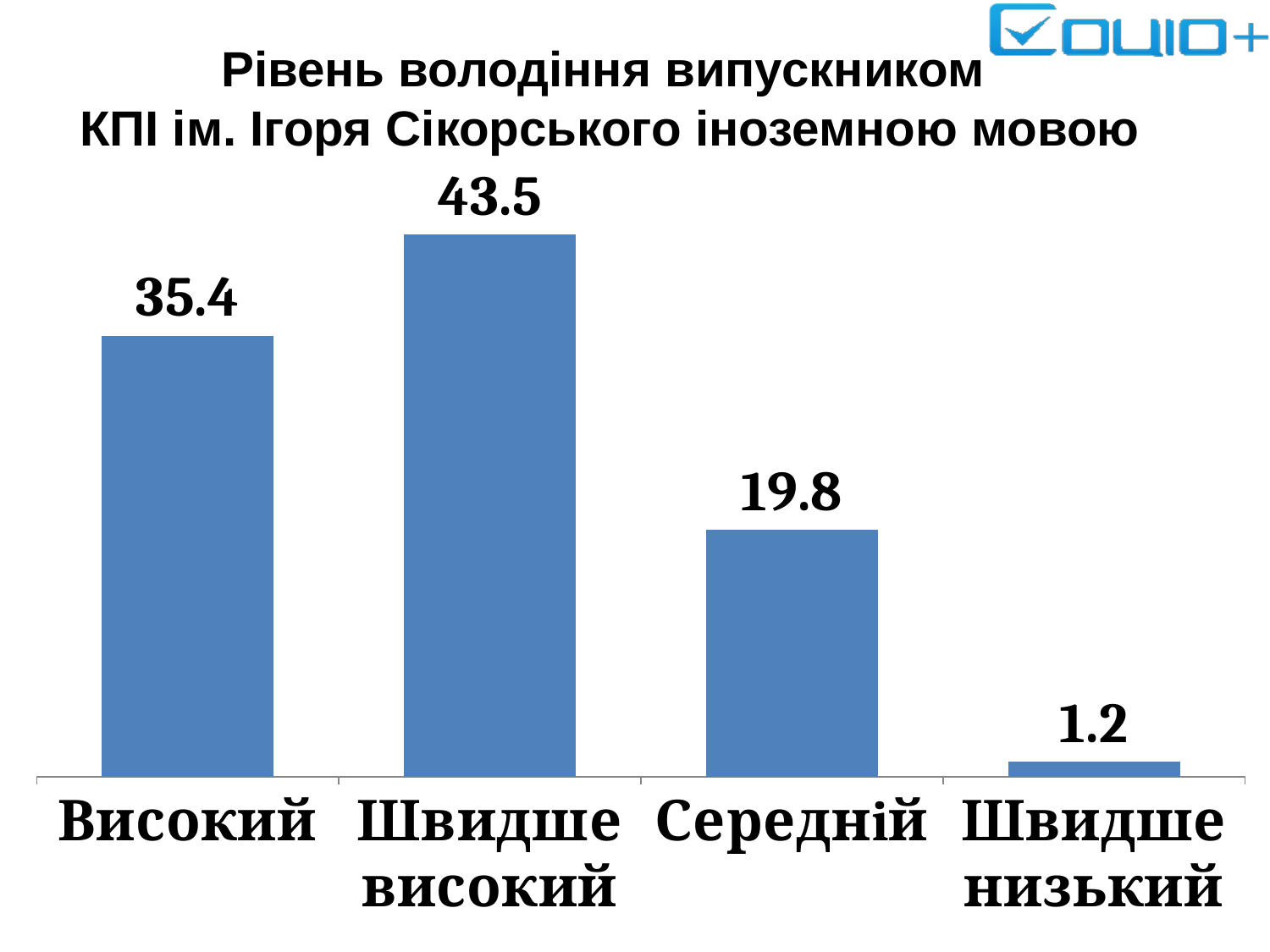
What is the difference between the values for "Швидше високий" and "Високий"? 8.1 Which is larger, the value for "Високий" or the value for "Середній"? Високий What is the value for the "Швидше високий" category? 43.5 Which category has the lowest value? Швидше низький Which category has the highest value? Швидше високий What is the title of the chart? Рівень володіння випускником КПІ ім. Ігоря Сікорського іноземною мовою What is the difference between the values for "Середній" and "Швидше низький"? 18.6 How many categories are shown in the chart? 4 What is the value for the "Середній" category? 19.8 What is the value for the "Високий" category? 35.4 What is the value for the "Швидше низький" category? 1.2 What kind of chart is shown on the slide? Bar chart